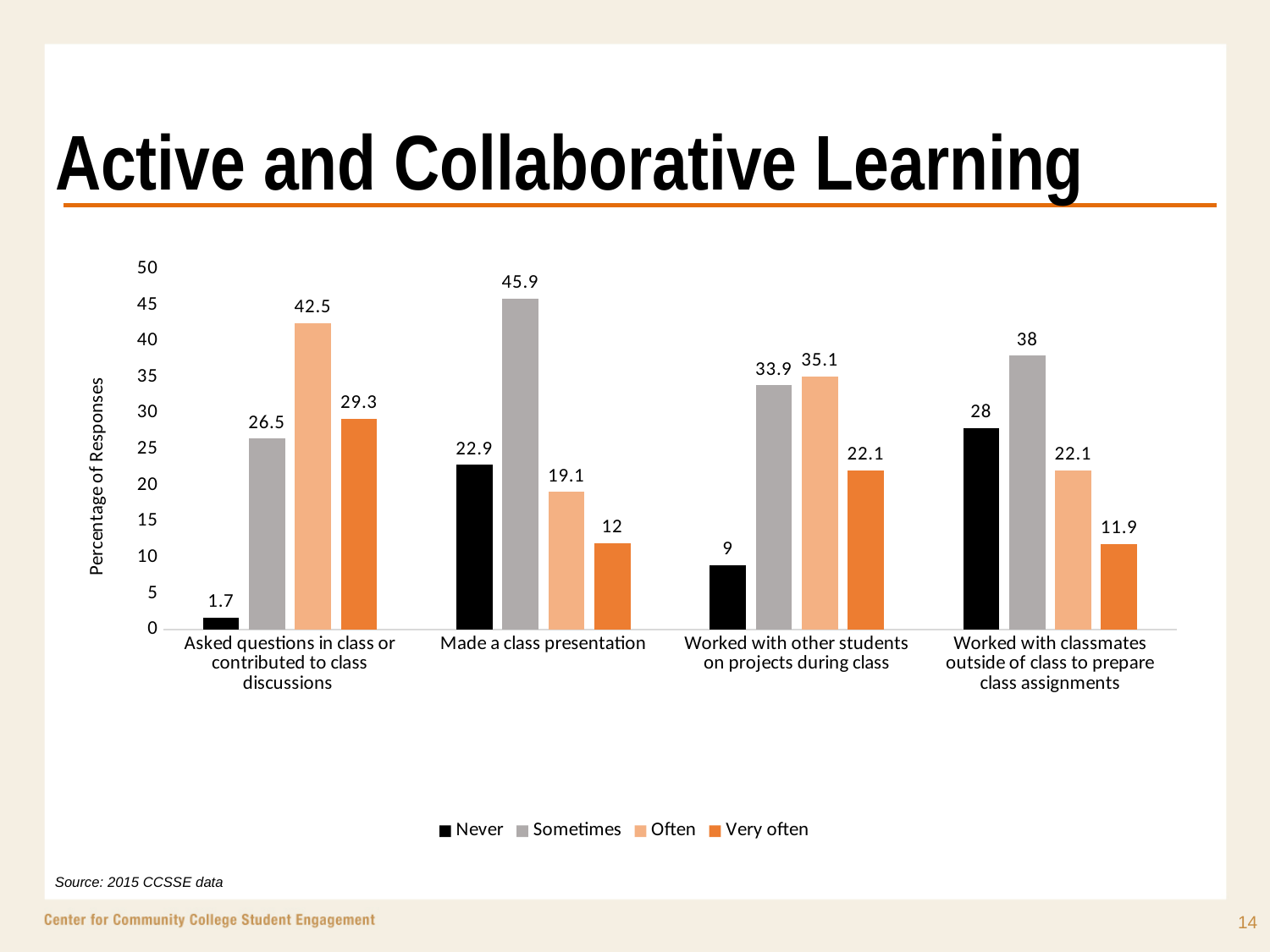
What is the label of the y axis? Percentage of Responses Which category has the highest "Sometimes" value? Made a class presentation Which category has the lowest "Never" value? Asked questions in class or contributed to class discussions What is the value for "Never" in the "Worked with other students on projects during class" category? 9 What kind of chart is shown on the slide? bar chart Is the "Very often" value for "Asked questions in class or contributed to class discussions" greater or less than 25? greater How many series does the legend list? 4 What is the value for "Often" in the "Asked questions in class or contributed to class discussions" category? 42.5 How many categories are shown on the x axis? 4 What is the difference between the "Often" and "Very often" values for "Made a class presentation"? 7.1 Which is larger for "Worked with classmates outside of class to prepare class assignments": the "Never" value or the "Often" value? Never What is the value for "Sometimes" in the "Worked with classmates outside of class to prepare class assignments" category? 38